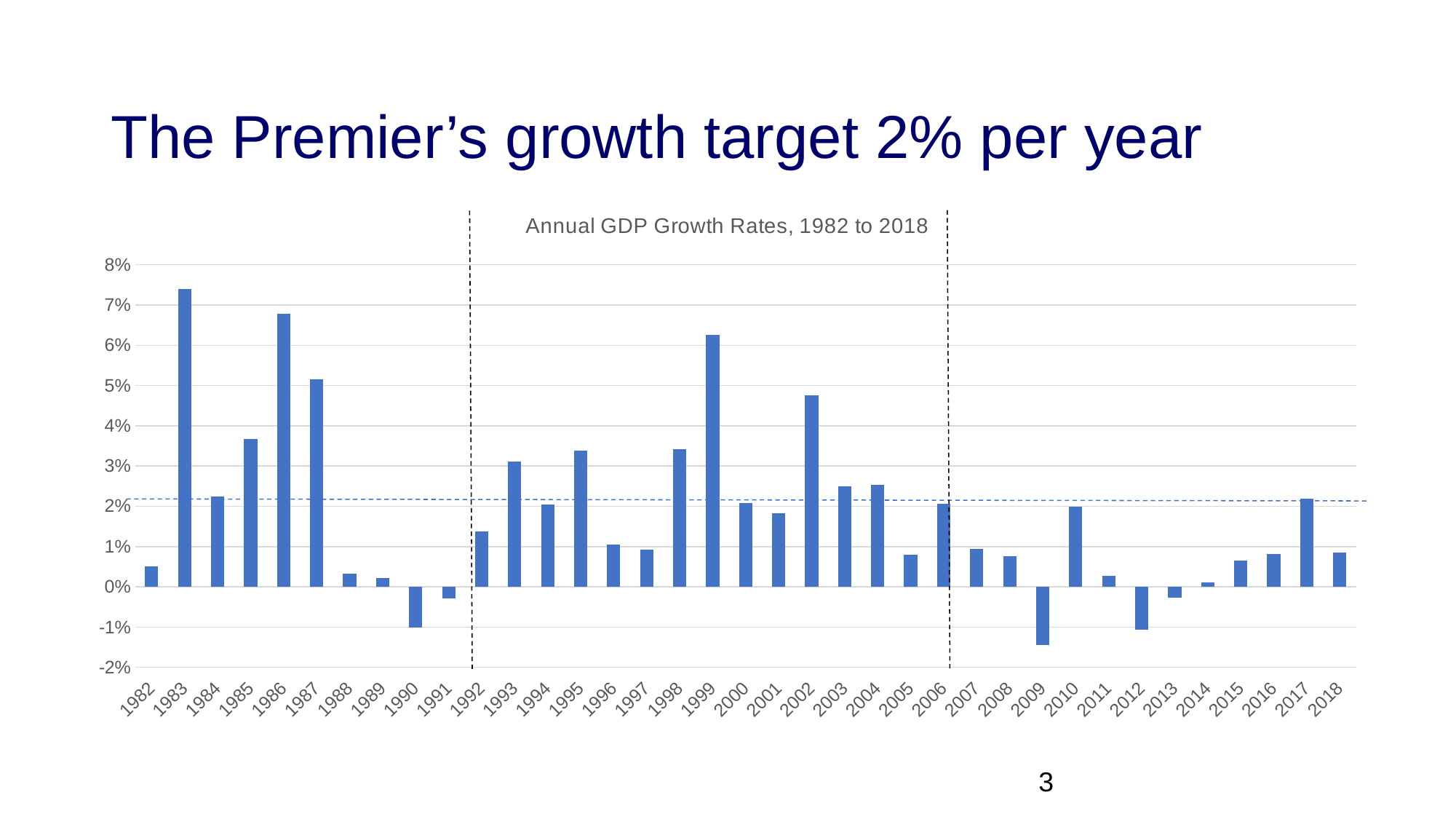
Which year has the larger GDP growth rate, 1999 or 2002? 1999 Which year has the larger GDP growth rate, 1985 or 1987? 1987 What kind of chart is shown on the slide? Bar chart Is the value for 2013 greater or less than 0%? less What is the title of the chart? Annual GDP Growth Rates, 1982 to 2018 How many years are plotted on the x axis of the chart? 37 Is the value for 1983 greater or less than 7%? greater Is the value for 1999 greater or less than 6%? greater Which year has the lowest GDP growth rate in the chart? 2009 Which year has the highest GDP growth rate in the chart? 1983